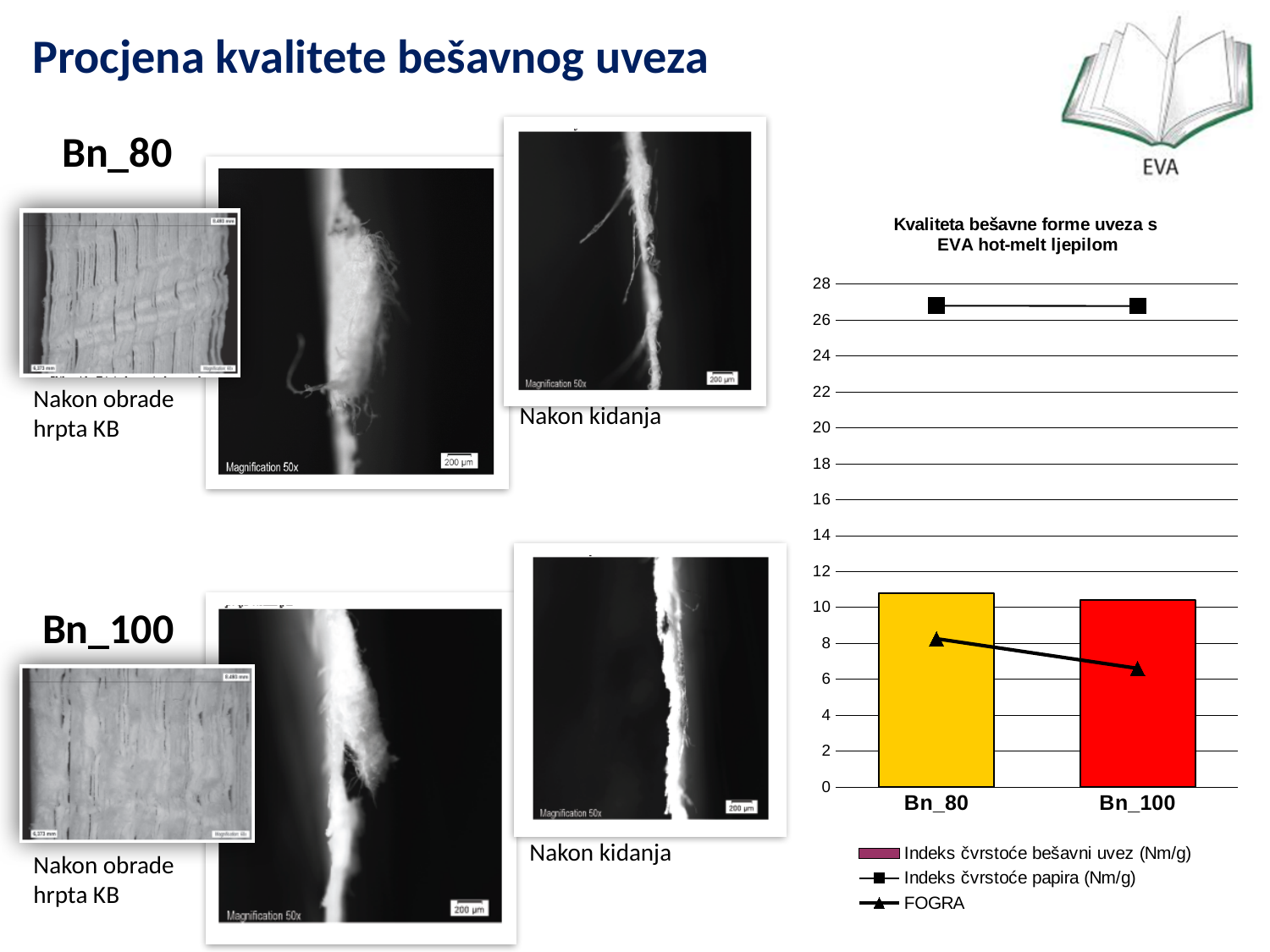
Is the Indeks čvrstoće bešavni uvez (Nm/g) bar for Bn_100 greater or less than 12? less Is the Indeks čvrstoće papira (Nm/g) value for Bn_80 greater or less than 26? greater What kind of chart is used for the Indeks čvrstoće bešavni uvez (Nm/g) series? bar chart What is the title of the chart on the right side of the slide? Kvaliteta bešavne forme uveza s EVA hot-melt ljepilom Is the FOGRA value for Bn_100 greater or less than 8? less Does the FOGRA series rise or fall from Bn_80 to Bn_100? fall How many series does the chart legend list? 3 Which category has the higher FOGRA value, Bn_80 or Bn_100? Bn_80 How many categories are shown on the x axis of the chart? 2 What colour is the bar for Bn_100 in the chart? red